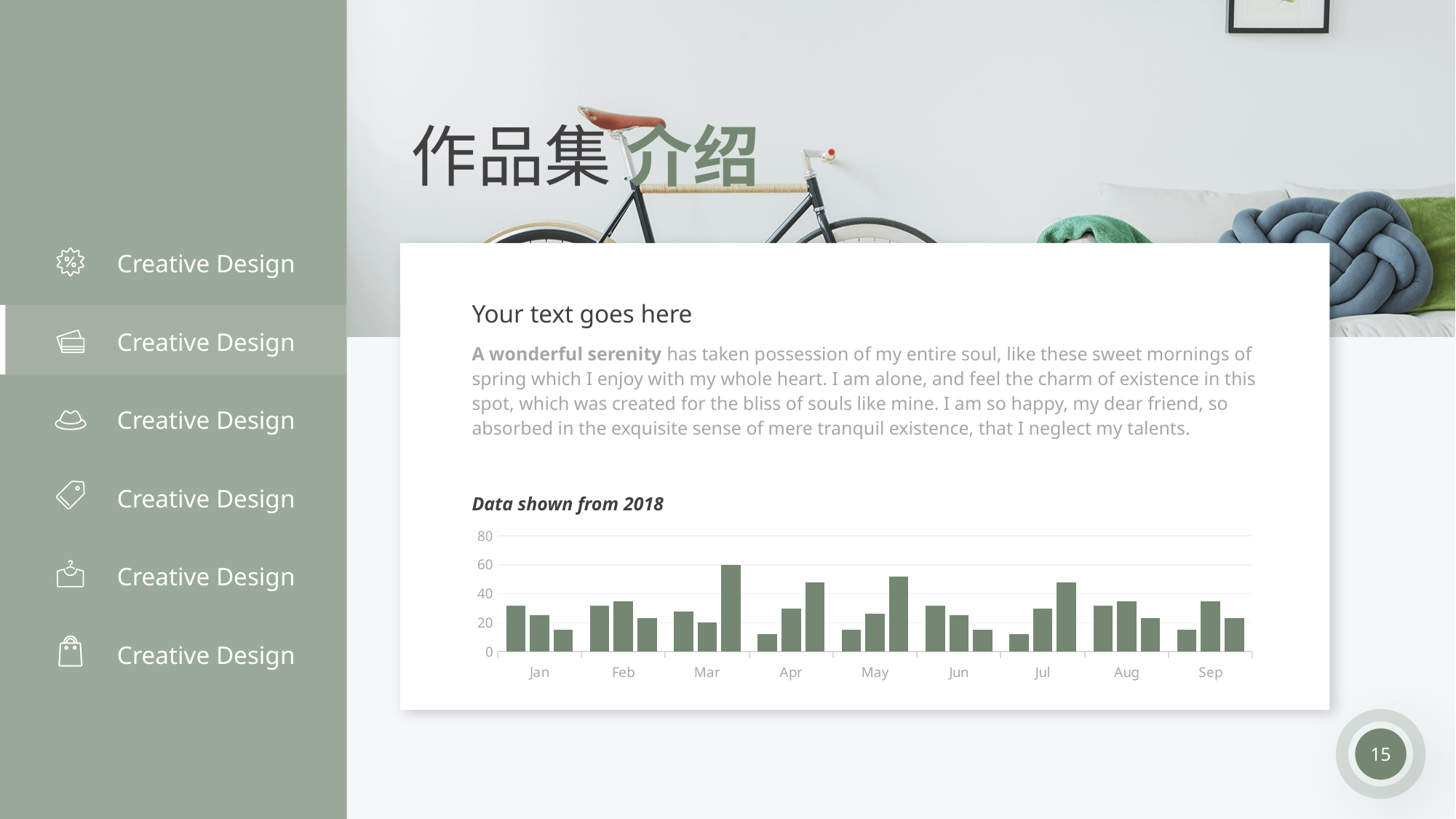
What kind of chart is shown on the slide? bar chart Which month contains the tallest bar in the chart? Mar Is the shortest bar for Jan greater or less than 20? less How many bars are plotted for each month in the chart? 3 Which is taller: the tallest bar for Mar or the tallest bar for Jun? Mar Is the tallest bar for Apr greater or less than 40? greater Is the tallest bar for Mar greater or less than 40? greater How many months are shown on the x axis of the chart? 9 What is the title of the chart? Data shown from 2018